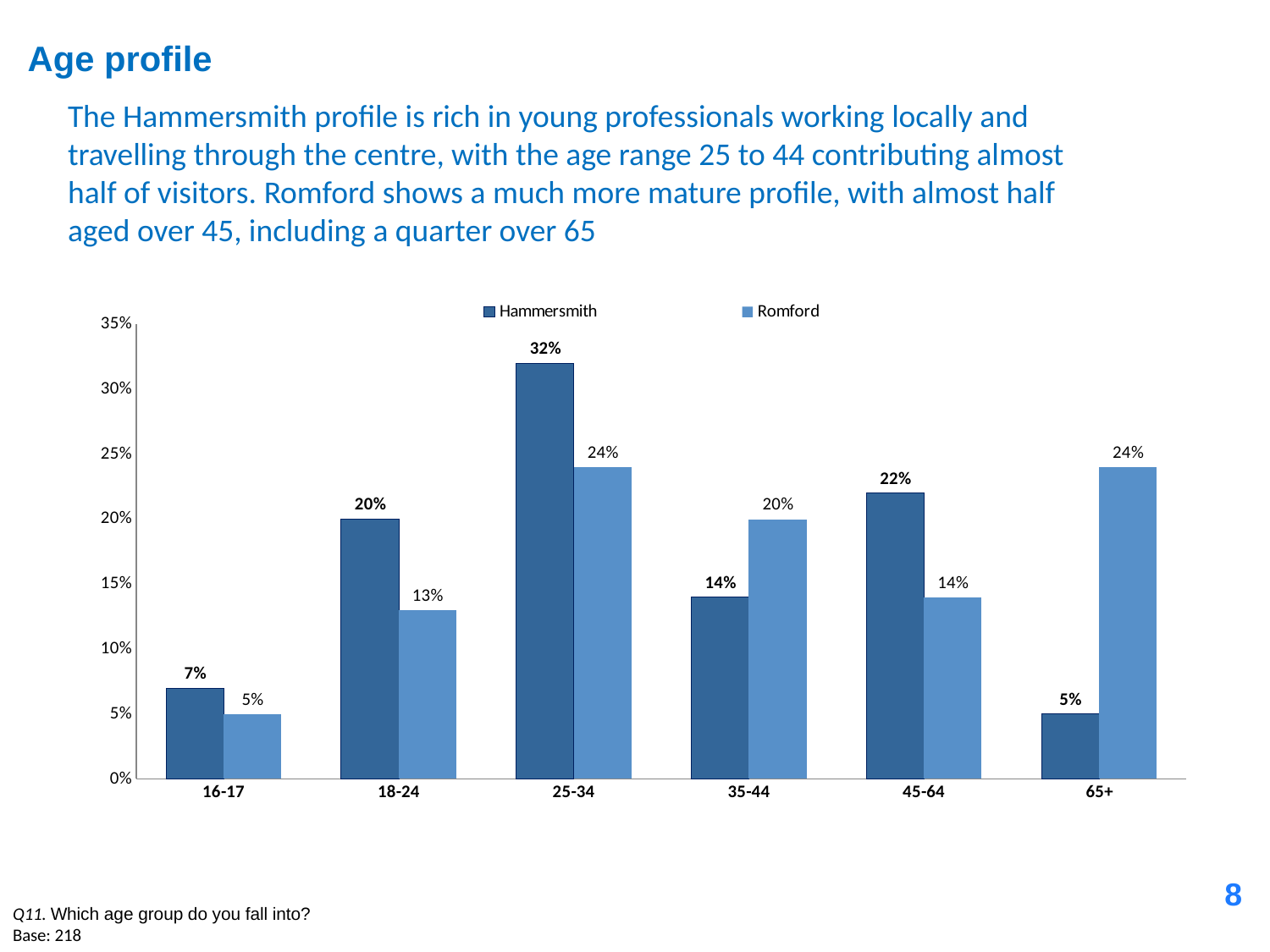
What is the Romford value for the 18-24 age group? 13% What is the difference between the Hammersmith and Romford values for the 65+ age group? 19% How many age groups are shown on the x axis? 6 What kind of chart is shown on the slide? Bar chart What is the Hammersmith value for the 25-34 age group? 32% Which age group has the lowest Hammersmith value? 65+ How many series does the legend list? 2 Which age group has the lowest Romford value? 16-17 What is the difference between the Hammersmith and Romford values for the 25-34 age group? 8% Which age group has the highest Hammersmith value? 25-34 For the 35-44 age group, which is larger: the Hammersmith value or the Romford value? Romford What is the Romford value for the 65+ age group? 24%